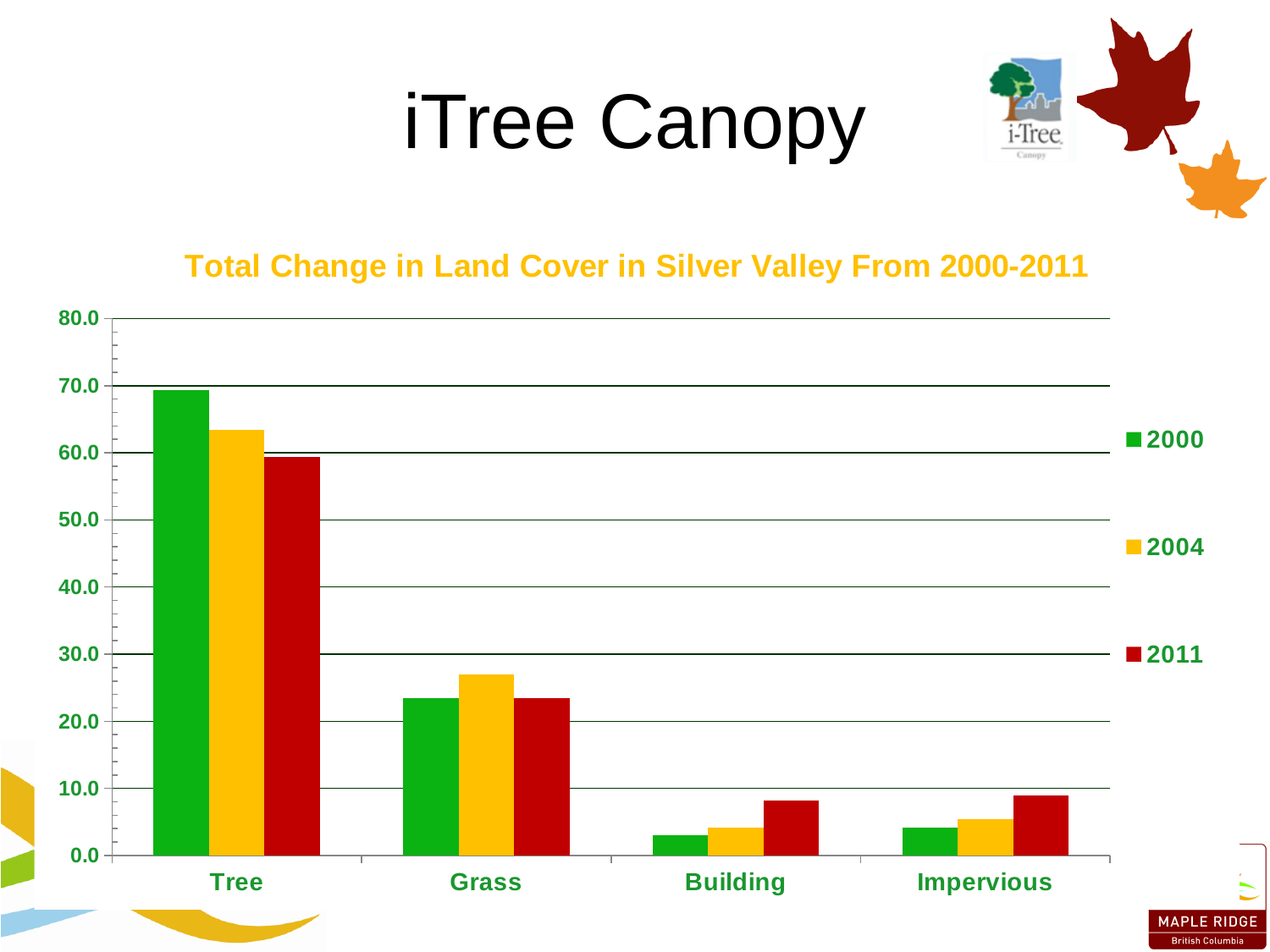
How many series does the legend list? 3 What is the title of the chart? Total Change in Land Cover in Silver Valley From 2000-2011 Which colour represents the 2004 series in the legend? yellow Which is larger, the Tree value in 2000 or the Tree value in 2011? Tree in 2000 Which land cover category has the lowest value in 2000? Building Is the value for Grass in 2004 greater or less than 30.0? less Is the value for Building in 2011 greater or less than 10.0? less How many land cover categories are shown on the x axis? 4 Which land cover category has the highest value in 2000? Tree Is the value for Tree in 2000 greater or less than 60.0? greater What kind of chart is shown on the slide? bar chart Does the Tree value rise or fall from 2000 to 2011? fall